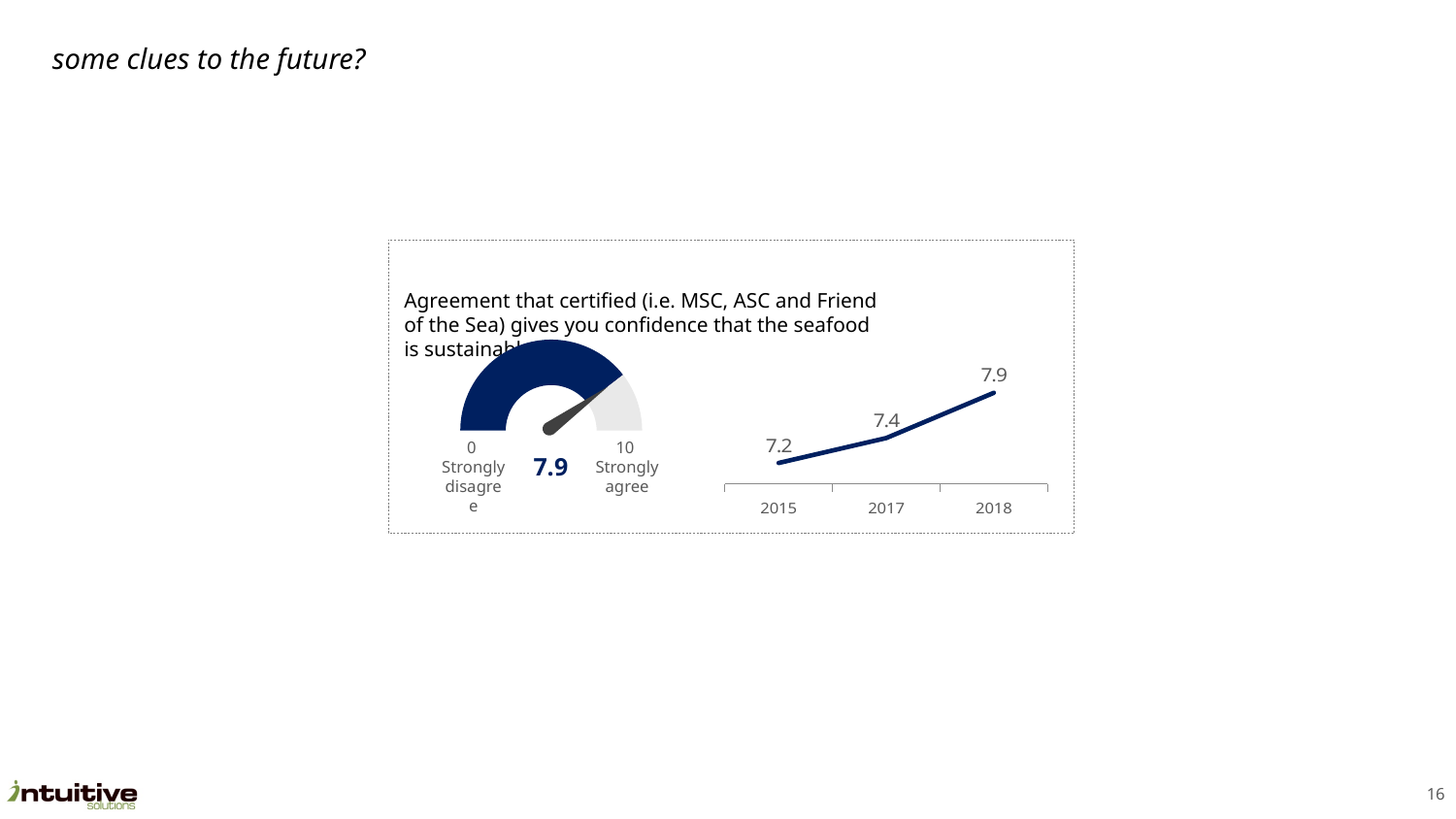
How many years are plotted in the line chart on the right? 3 In the line chart on the right, do the values rise or fall from 2015 to 2018? rise What kind of chart is shown on the right of the slide? line chart In the line chart on the right, is the value for 2017 larger or smaller than the value for 2018? smaller In the line chart on the right, what is the difference between the 2017 and 2015 values? 0.2 In the line chart on the right, what is the value for 2018? 7.9 In the line chart on the right, which year has the highest value? 2018 In the line chart on the right, what is the value for 2017? 7.4 In the line chart on the right, what is the value for 2015? 7.2 In the line chart on the right, which year has the lowest value? 2015 In the line chart on the right, what is the difference between the 2018 and 2015 values? 0.7 What value does the gauge chart on the left display? 7.9